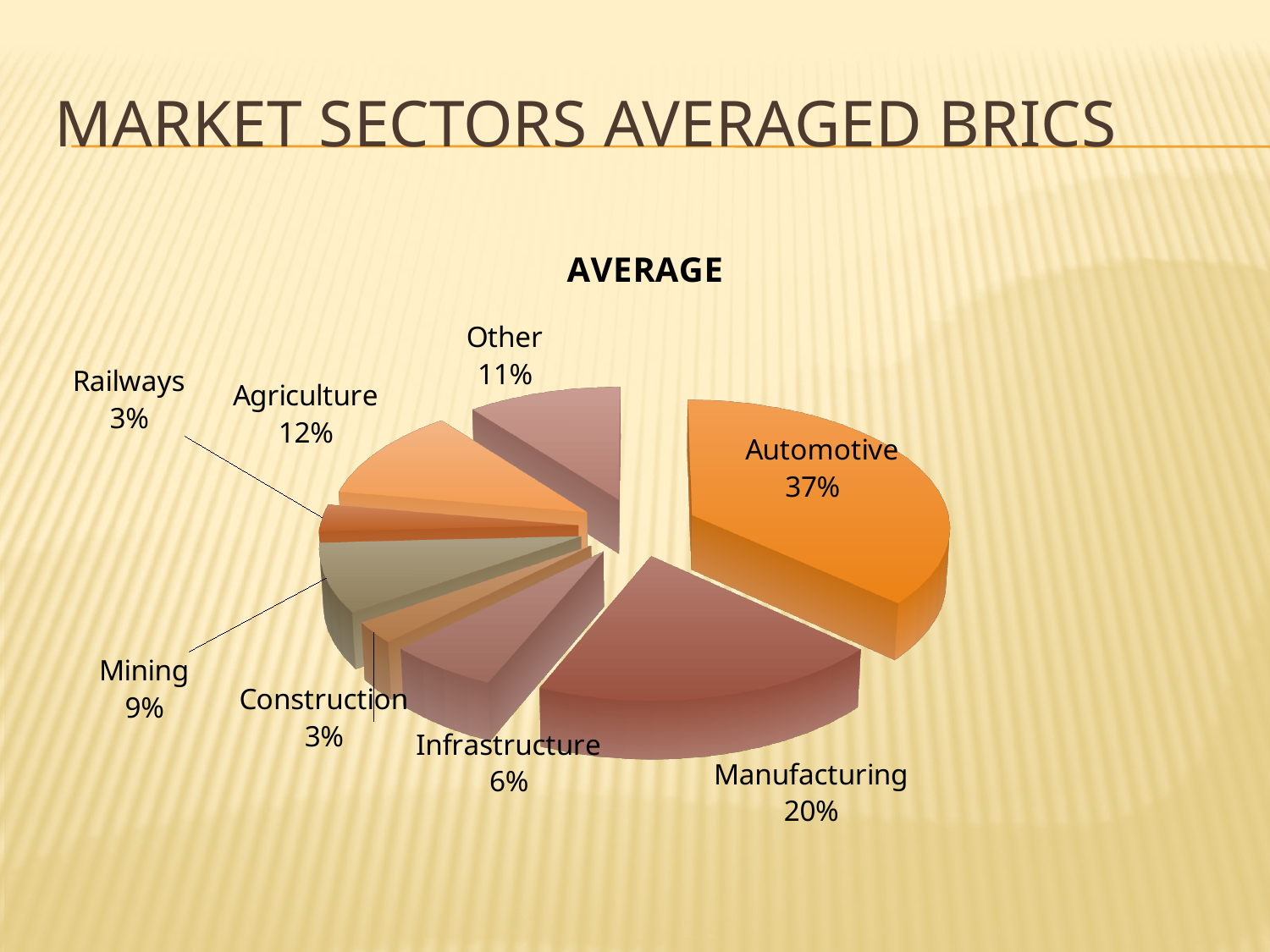
What percentage is shown for Mining? 9% Which sectors share the smallest slice of the pie? Railways and Construction Which sector has the largest share of the pie? Automotive What is the combined share of Infrastructure and Construction? 9% Which is larger, the Agriculture share or the Other share? Agriculture What is the title of the chart? AVERAGE What is the value for Agriculture? 12% What kind of chart is shown on the slide? Pie chart What percentage is shown for Manufacturing? 20% What is the difference between the Automotive and Manufacturing shares? 17% How many sectors are shown in the pie chart? 8 What share of the pie does Automotive have? 37%